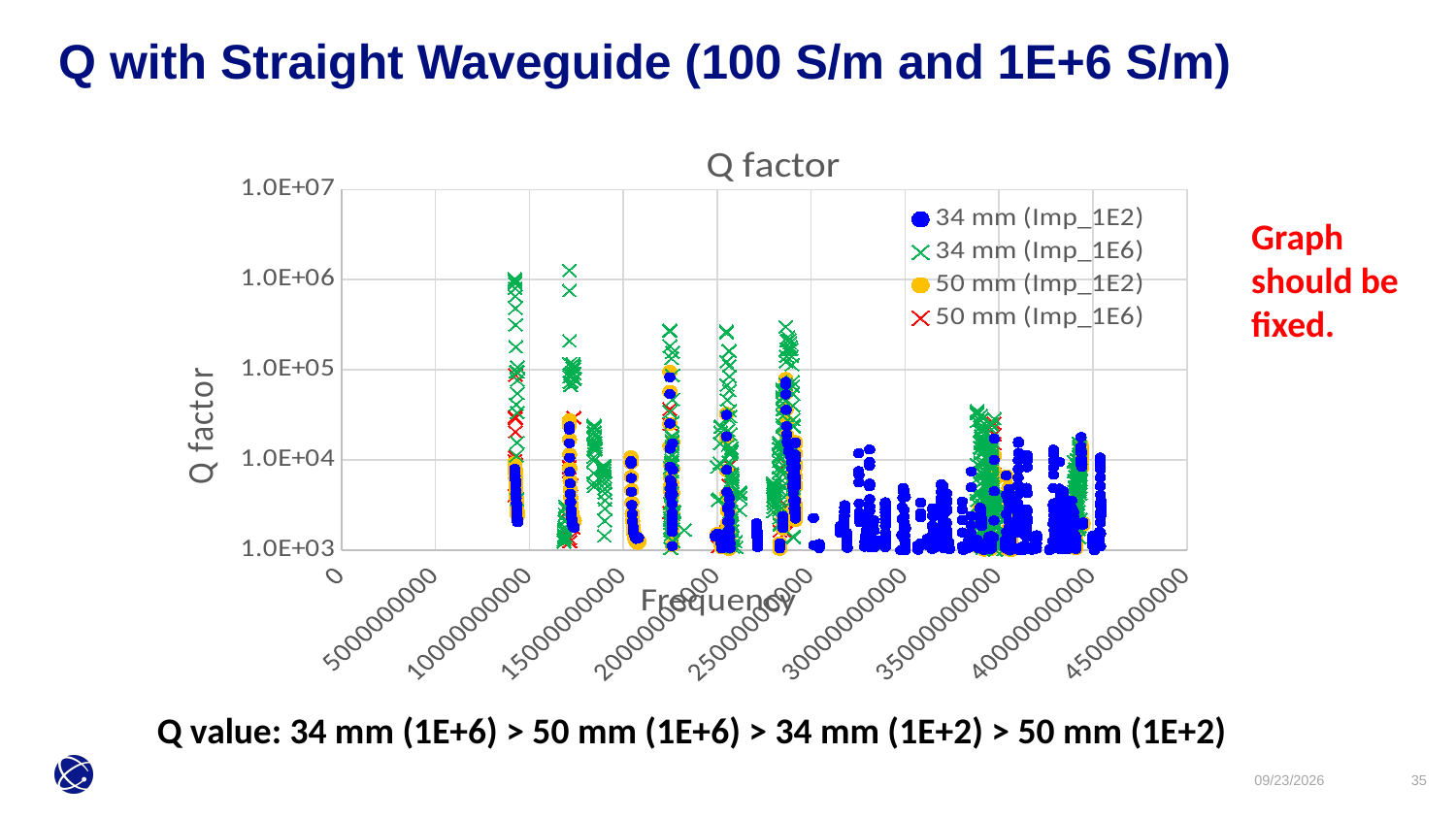
What is the highest tick value shown on the y axis? 1.0E+07 How many tick labels are shown on the x axis? 10 Which series reaches the highest Q factor values on the chart? 34 mm (Imp_1E6) Which series has the lowest Q values according to the slide? 50 mm (1E+2) What is the title of the chart? Q factor What kind of chart is shown on the slide? Scatter chart Is the highest value for the 34 mm (Imp_1E6) series greater or less than 1.0E+06? greater How many series does the chart legend list? 4 What is the lowest tick value shown on the y axis? 1.0E+03 What is the largest tick value shown on the x axis? 45000000000 Is the highest value for the 34 mm (Imp_1E2) series greater or less than 1.0E+06? less Which series is plotted with blue circle markers? 34 mm (Imp_1E2)